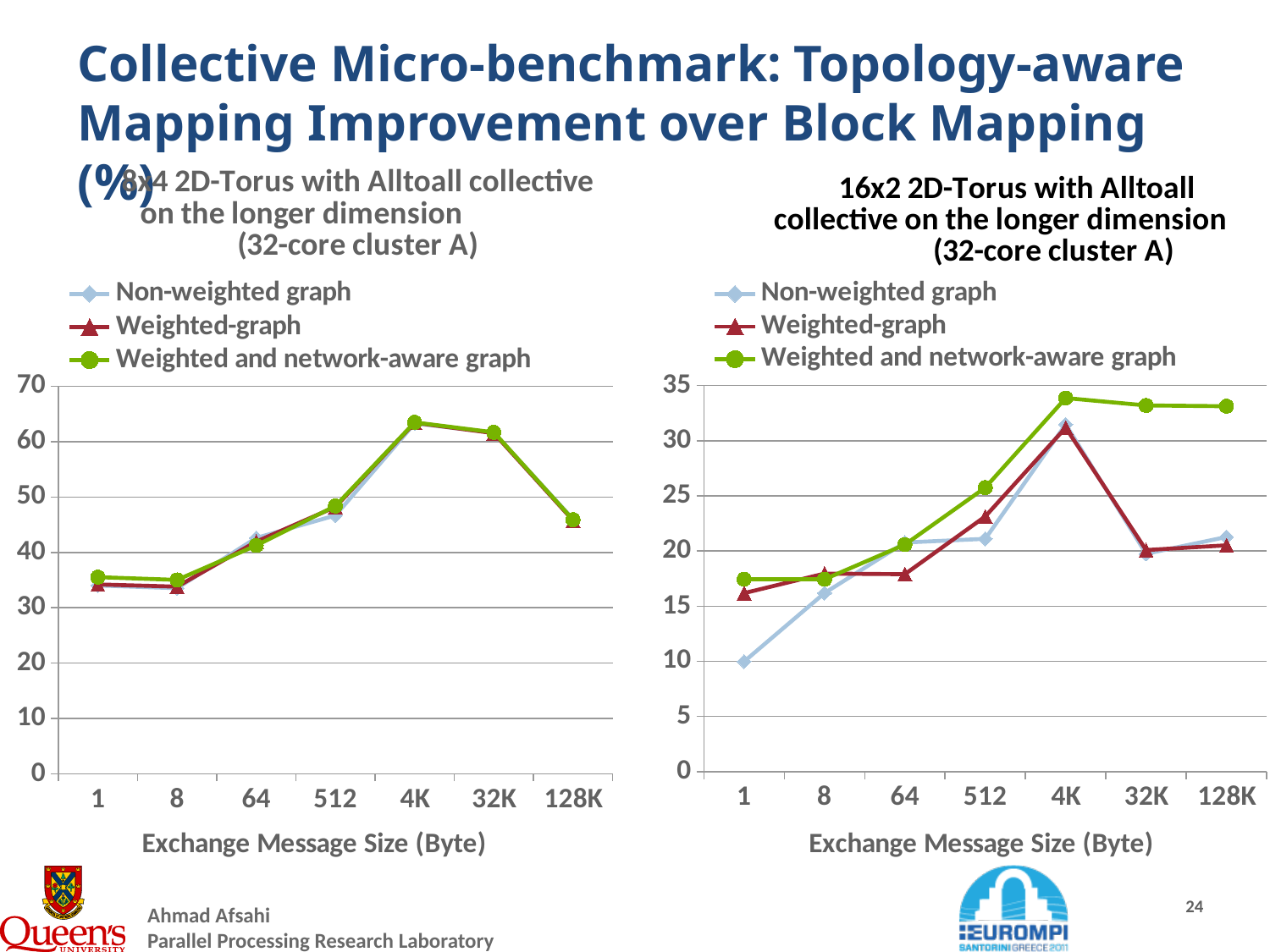
In the right chart (16x2 2D-Torus), is the value for the Weighted and network-aware graph at 128K greater or less than 30? greater In the right chart (16x2 2D-Torus), at which message size is the Non-weighted graph series lowest? 1 In the left chart (8x4 2D-Torus), at which message size does the Weighted and network-aware graph series reach its highest value? 4K How many series does the legend of the right chart (16x2 2D-Torus) list? 3 In the right chart (16x2 2D-Torus), is the value for the Non-weighted graph at message size 1 greater or less than 15? less In the right chart (16x2 2D-Torus), at which message size does the Weighted and network-aware graph series reach its highest value? 4K In the left chart (8x4 2D-Torus), is the value for the Weighted and network-aware graph at 4K greater or less than 60? greater In the right chart (16x2 2D-Torus), at 32K, which series has the larger value: Weighted-graph or Weighted and network-aware graph? Weighted and network-aware graph How many message sizes are plotted along the x axis of the left chart (8x4 2D-Torus)? 7 What type of chart is the left chart (8x4 2D-Torus)? line chart In the left chart (8x4 2D-Torus), do the values rise or fall from 4K to 128K? fall